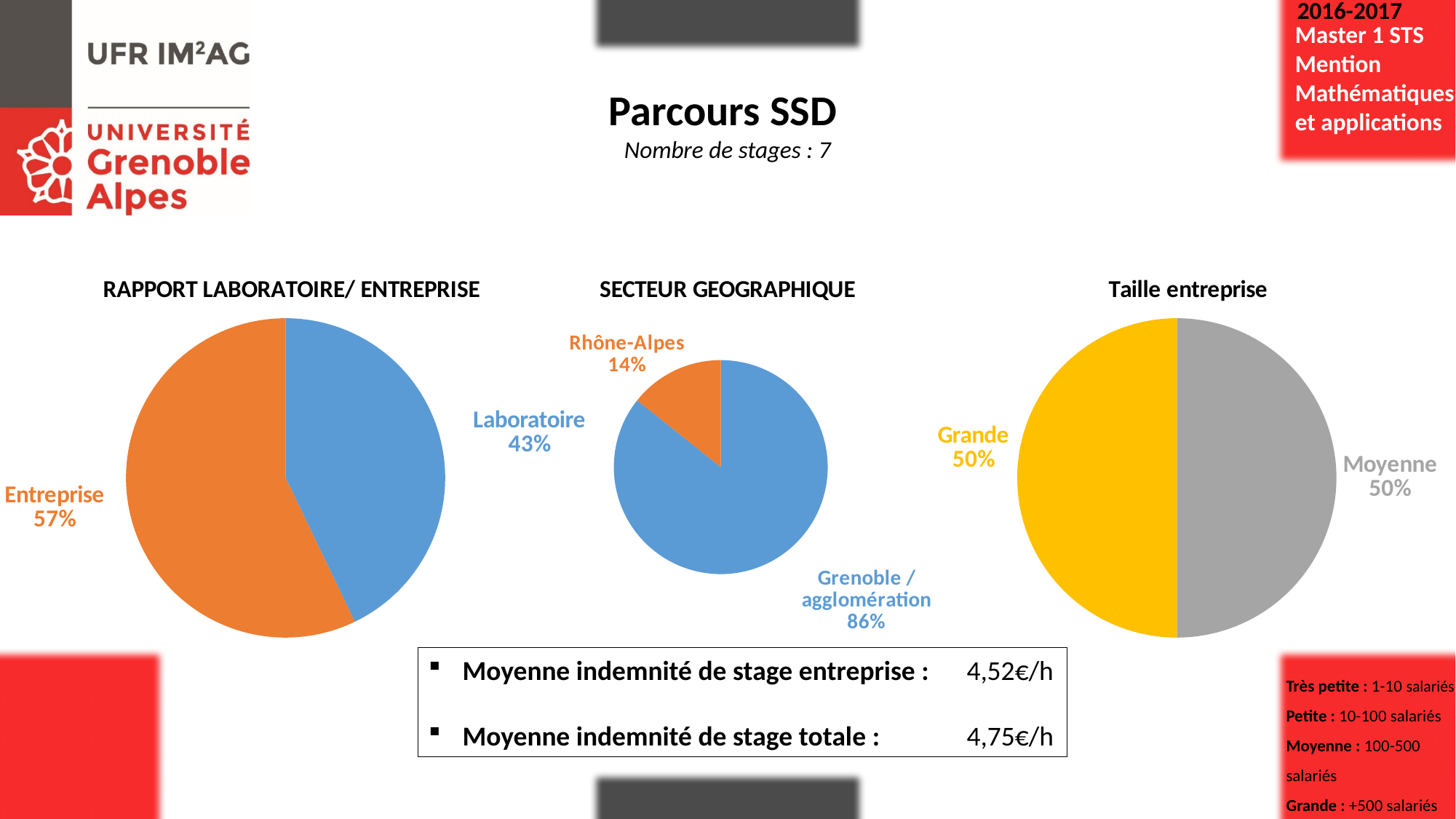
In the RAPPORT LABORATOIRE/ ENTREPRISE chart, what is the difference in percentage points between Entreprise and Laboratoire? 14 What kind of chart is the Taille entreprise chart? Pie chart In the Taille entreprise chart, what colour is the Grande slice? Yellow In the RAPPORT LABORATOIRE/ ENTREPRISE chart, what share does Laboratoire have? 43% In the SECTEUR GEOGRAPHIQUE chart, what share does Rhône-Alpes have? 14% In the Taille entreprise chart, what share does Grande have? 50% In the SECTEUR GEOGRAPHIQUE chart, what share does Grenoble / agglomération have? 86% In the RAPPORT LABORATOIRE/ ENTREPRISE chart, which slice is the largest? Entreprise In the SECTEUR GEOGRAPHIQUE chart, how many slices are there? 2 In the Taille entreprise chart, what share does Moyenne have? 50% In the RAPPORT LABORATOIRE/ ENTREPRISE chart, what share does Entreprise have? 57% In the SECTEUR GEOGRAPHIQUE chart, which slice is the smallest? Rhône-Alpes